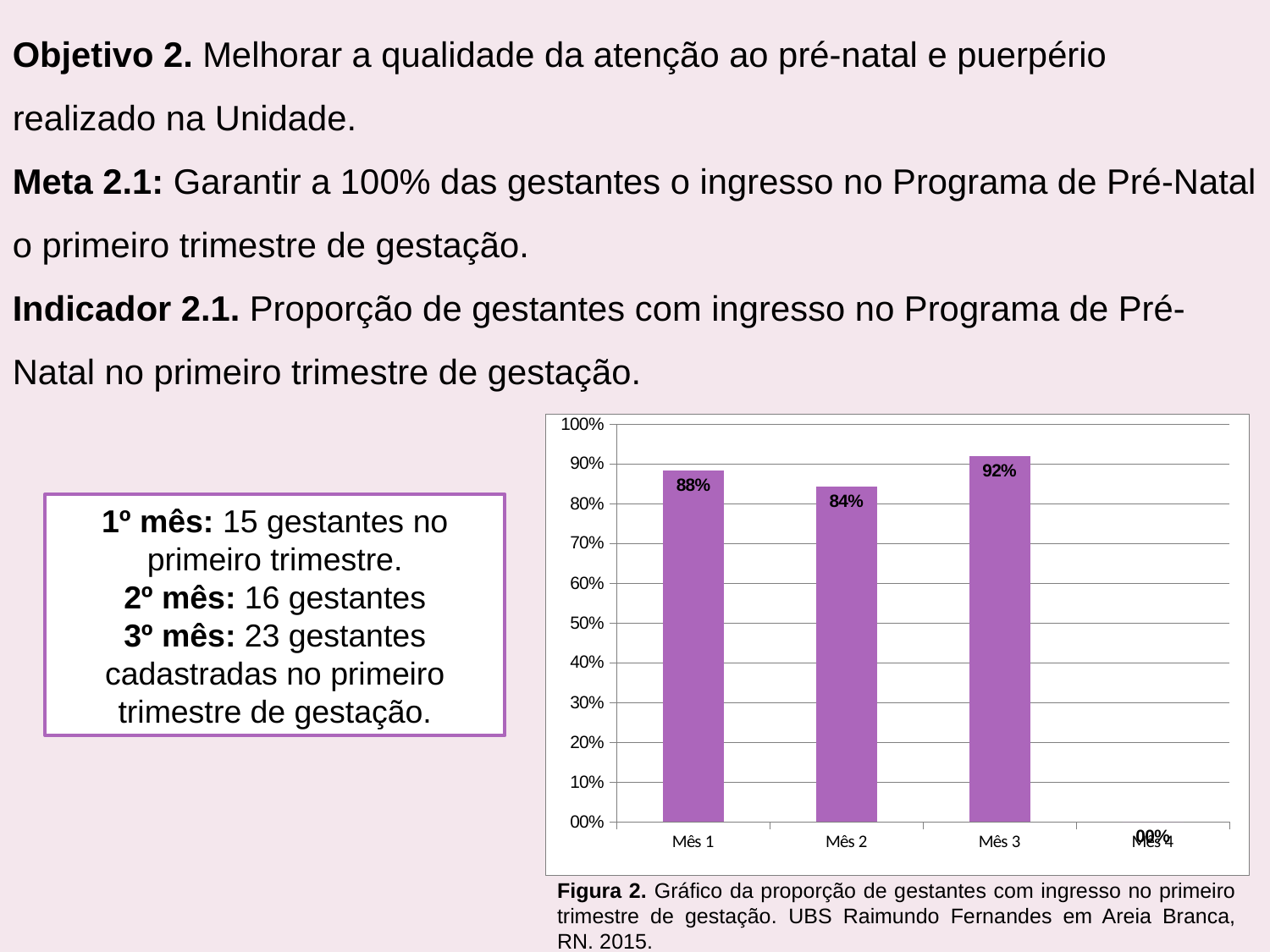
Which is larger, the value for Mês 1 or the value for Mês 3? Mês 3 What kind of chart is shown on the slide? bar chart What is the value for Mês 3? 92% What is the figure number given in the caption below the chart? Figura 2 What is the difference between the values for Mês 3 and Mês 2? 8% What is the value for Mês 2? 84% What is the difference between the values for Mês 1 and Mês 2? 4% How many month categories are shown on the x axis? 4 Which month has the highest value? Mês 3 Among the months with a visible bar, which has the lowest value? Mês 2 What is the value for Mês 1? 88% Is the value for Mês 2 greater or less than 90%? less